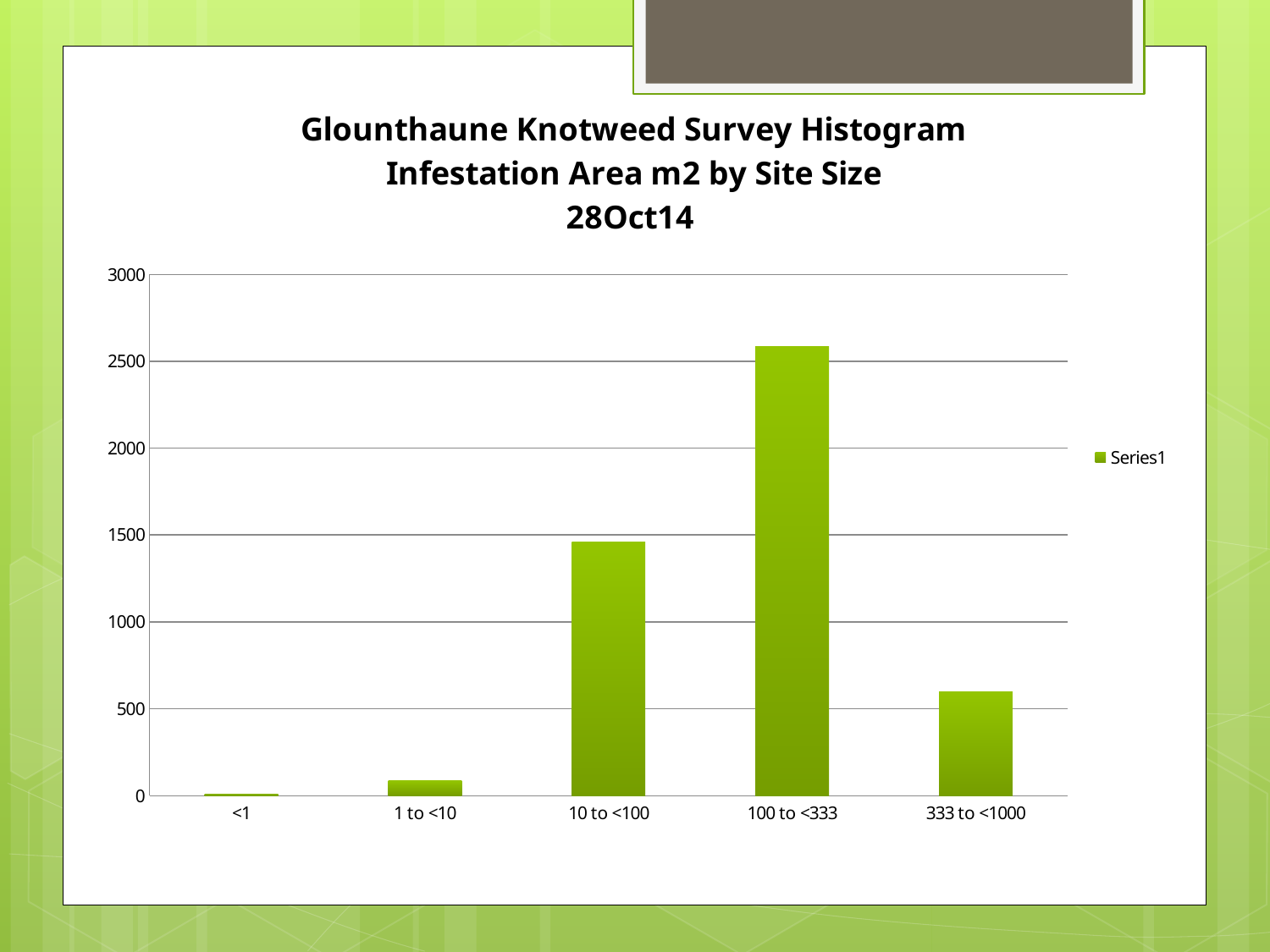
How many site size categories are shown on the x axis? 5 What date is given in the chart title? 28Oct14 What type of chart is shown on the slide? bar chart Is the value for 333 to <1000 greater or less than 1000? less Which is larger, the value for 10 to <100 or the value for 333 to <1000? 10 to <100 How many series does the legend list? 1 Is the value for 100 to <333 greater or less than 2000? greater Which site size category has the highest infestation area? 100 to <333 Is the value for 10 to <100 greater or less than 1000? greater Which site size category has the lowest infestation area? <1 What is the name of the series shown in the legend? Series1